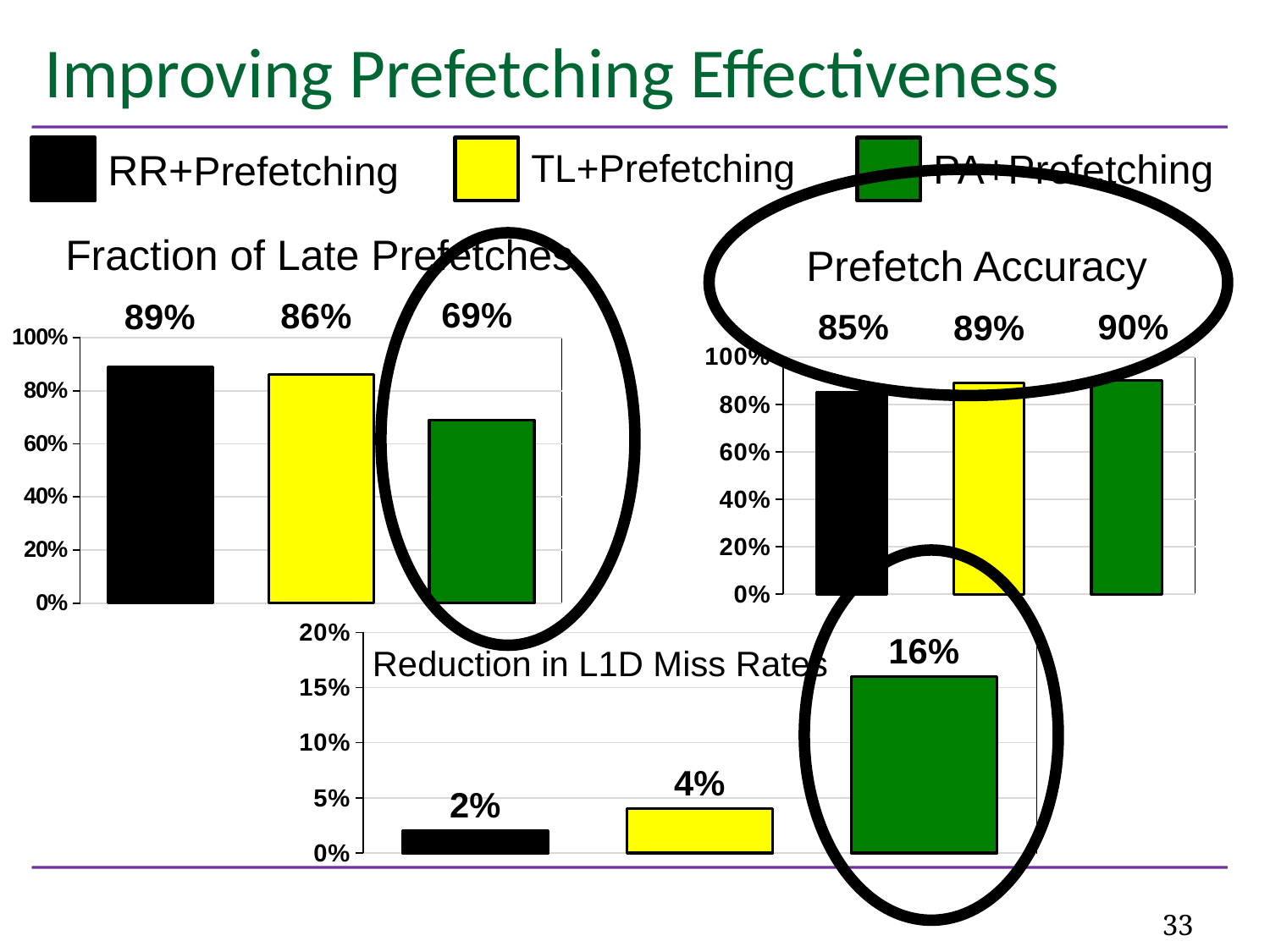
How many series does the legend at the top of the slide list? 3 In the Reduction in L1D Miss Rates chart, what is the value for PA+Prefetching? 16% In the Prefetch Accuracy chart, which is larger, the value for RR+Prefetching or the value for PA+Prefetching? PA+Prefetching What kind of chart is the Prefetch Accuracy chart? bar chart In the Reduction in L1D Miss Rates chart, which series has the highest value? PA+Prefetching In the Prefetch Accuracy chart, what is the value for TL+Prefetching? 89% In the Fraction of Late Prefetches chart, what is the difference between the RR+Prefetching and PA+Prefetching values? 20% In the Reduction in L1D Miss Rates chart, is the value for PA+Prefetching greater or less than 10%? greater In the Fraction of Late Prefetches chart, which series has the lowest value? PA+Prefetching In the Fraction of Late Prefetches chart, what is the value for PA+Prefetching? 69% In the Reduction in L1D Miss Rates chart, what is the difference between the PA+Prefetching and TL+Prefetching values? 12% In the Fraction of Late Prefetches chart, what is the value for RR+Prefetching? 89%